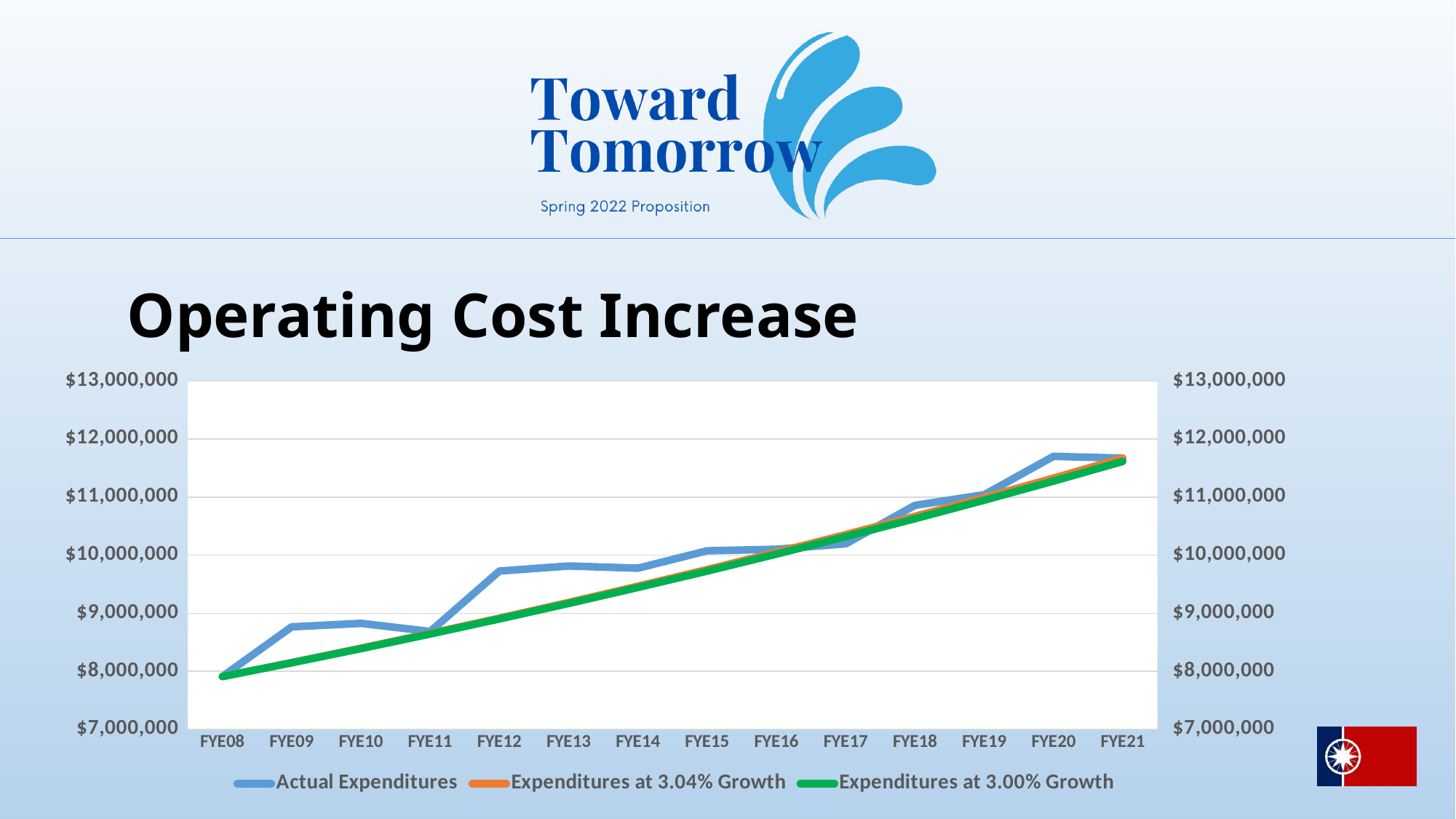
What kind of chart is shown on the slide? line chart Is the value for Actual Expenditures at FYE12 greater or less than $9,000,000? greater How many fiscal years are plotted along the x axis? 14 Do the Actual Expenditures generally rise or fall from FYE08 to FYE21? rise Which series is drawn in green in the legend? Expenditures at 3.00% Growth Is the value for Actual Expenditures at FYE20 greater or less than $11,000,000? greater What is the title of the slide containing the chart? Operating Cost Increase Is the value for Actual Expenditures at FYE21 greater or less than $12,000,000? less How many series does the legend list? 3 In which fiscal year are Actual Expenditures lowest? FYE08 At FYE12, which is larger: Actual Expenditures or Expenditures at 3.00% Growth? Actual Expenditures